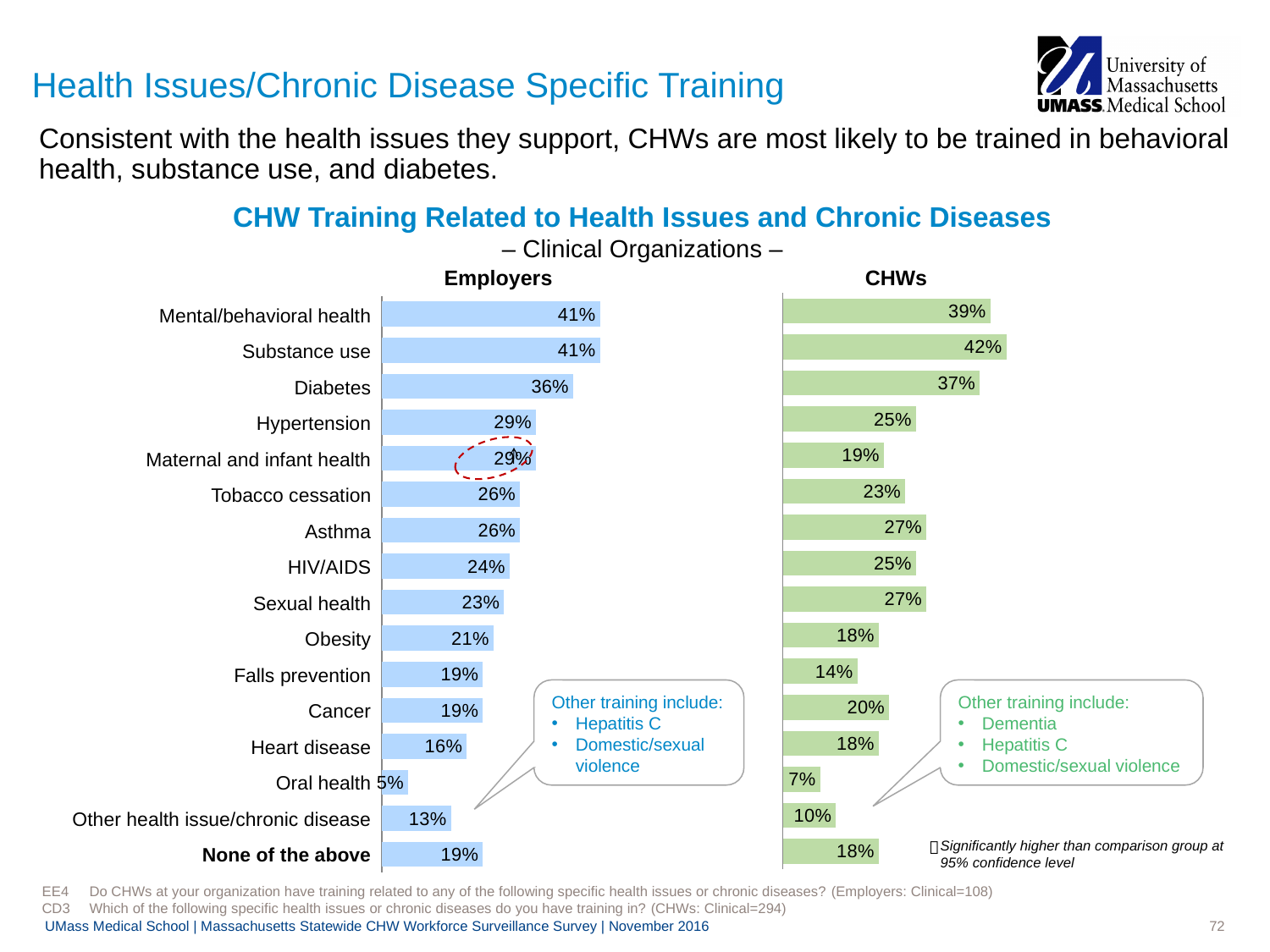
Which is larger: the Employers value for Asthma or the CHWs value for Asthma? CHWs (27%) In the Employers chart, what percentage is shown for Diabetes? 36% In the Employers chart, what is the difference between the values for Hypertension and Heart disease? 13% What type of chart is used to show the Employers data? Bar chart How many categories are listed in the Employers chart? 16 In the CHWs chart, which category has the lowest value? Oral health In the Employers chart, which category has the lowest value? Oral health In the Employers chart, what percentage is shown for Oral health? 5% In the CHWs chart, which category has the highest value? Substance use In the CHWs chart, what percentage is shown for Substance use? 42% In the CHWs chart, what is the difference between the values for Mental/behavioral health and Falls prevention? 25% In the CHWs chart, what percentage is shown for Maternal and infant health? 19%